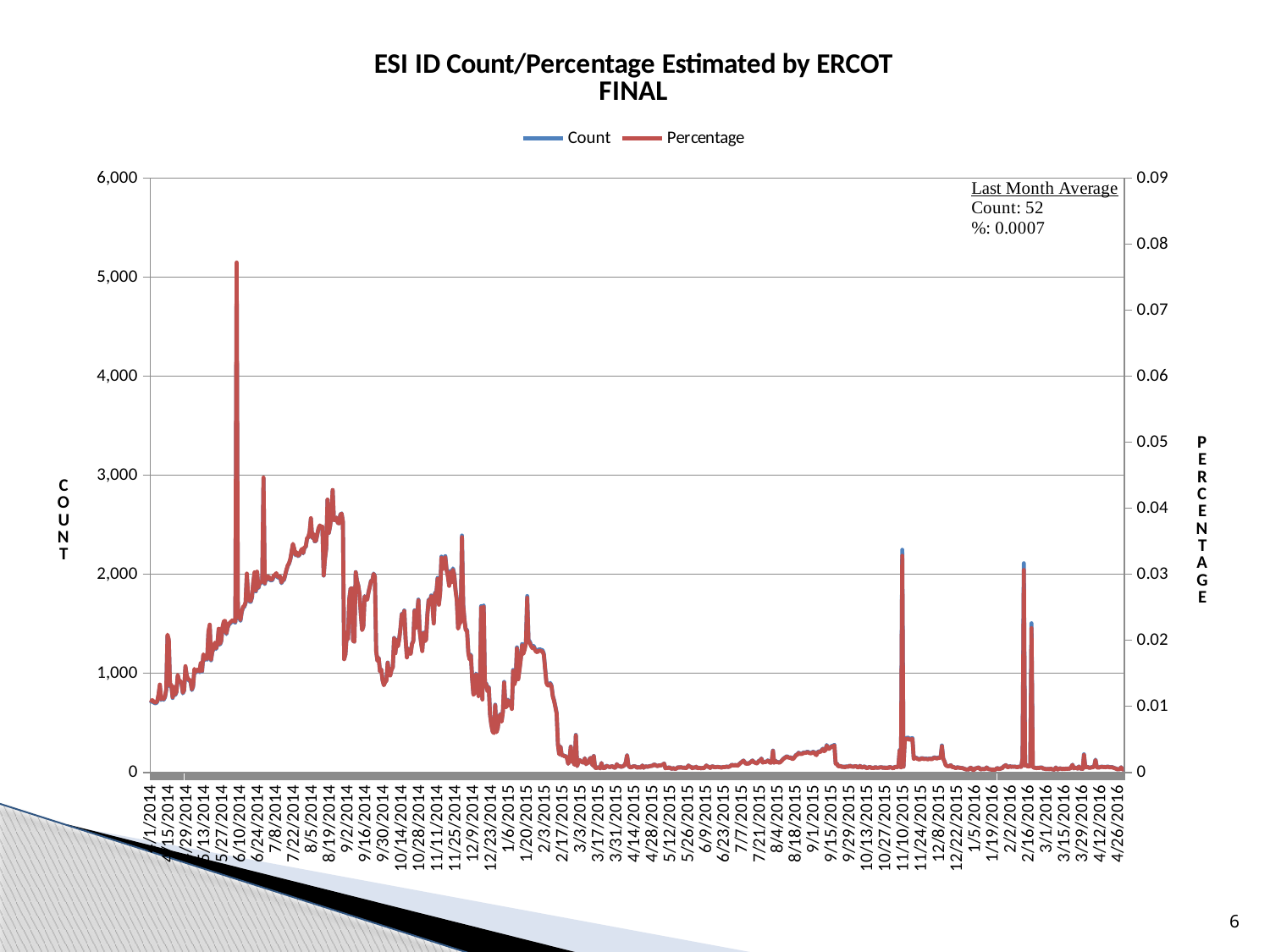
According to the annotation on the chart, what is the Last Month Average Count? 52 Around which date on the x axis does the Count series reach its highest peak? 6/10/2014 Is the Count spike near 11/10/2015 greater or less than 2,000? greater What is the title of the chart? ESI ID Count/Percentage Estimated by ERCOT FINAL Is the Count value around 6/9/2015 greater or less than 1,000? less How many series does the legend list? 2 What kind of chart is shown on the slide? line chart According to the annotation on the chart, what is the Last Month Average percentage (%)? 0.0007 Overall, do the Count values rise or fall from 2014 to 2016 along the x axis? fall Is the peak Count value near 6/10/2014 greater or less than 5,000? greater What are the two series named in the legend? Count and Percentage